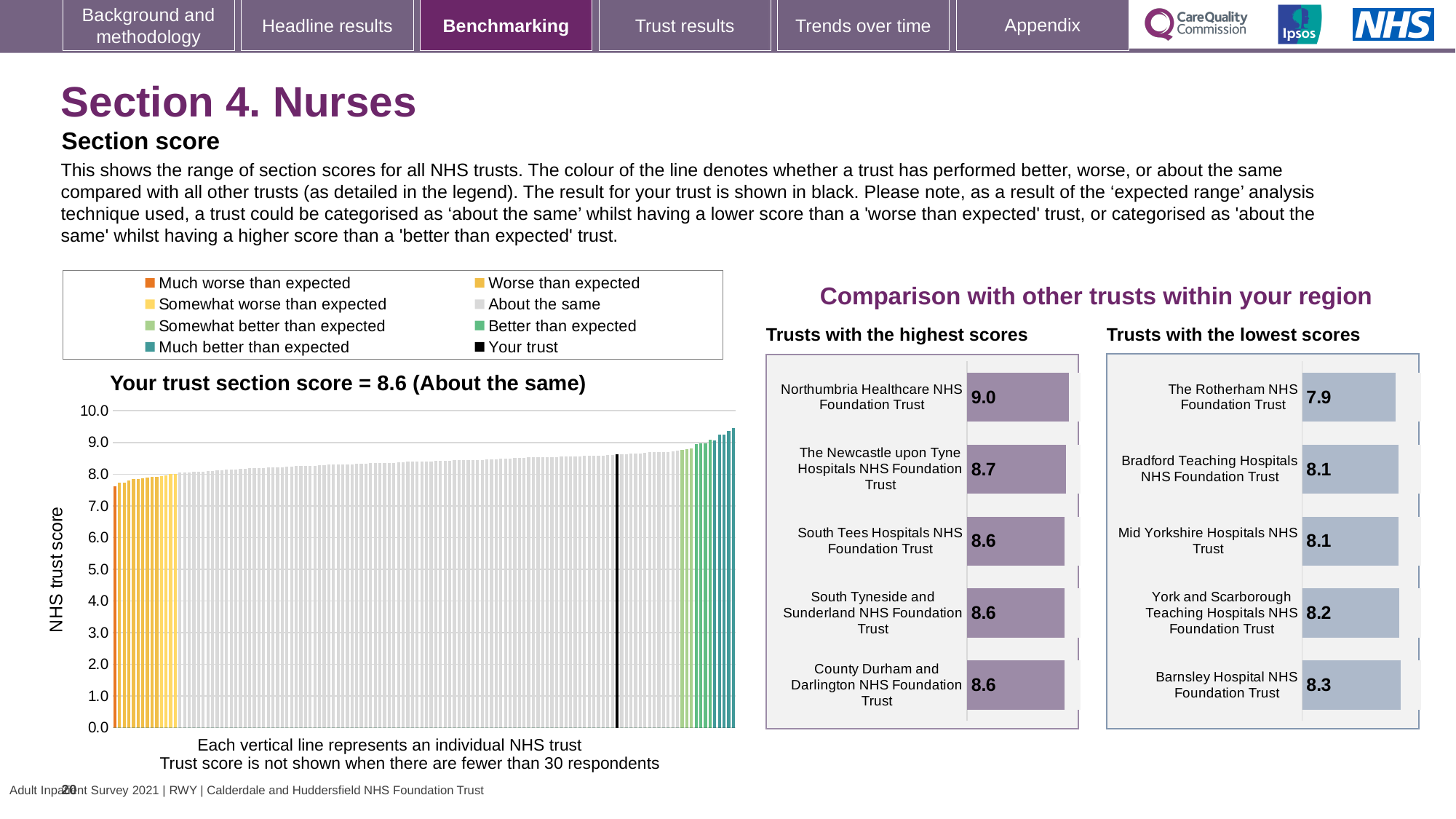
In the 'Trusts with the lowest scores' chart, what is the score for Barnsley Hospital NHS Foundation Trust? 8.3 In the 'Trusts with the highest scores' chart, what is the score for Northumbria Healthcare NHS Foundation Trust? 9.0 In the main chart on the left showing all NHS trusts, is the value of the leftmost (lowest) bar greater or less than 8.0? less In the 'Trusts with the highest scores' chart, what is the difference between the scores of Northumbria Healthcare NHS Foundation Trust and South Tees Hospitals NHS Foundation Trust? 0.4 In the 'Trusts with the highest scores' chart, what is the score for The Newcastle upon Tyne Hospitals NHS Foundation Trust? 8.7 What kind of chart is the main chart on the left showing all NHS trusts? bar chart In the 'Trusts with the lowest scores' chart, what is the score for The Rotherham NHS Foundation Trust? 7.9 In the main chart on the left showing all NHS trusts, what is your trust's section score? 8.6 In the 'Trusts with the lowest scores' chart, which has the larger score: York and Scarborough Teaching Hospitals NHS Foundation Trust or The Rotherham NHS Foundation Trust? York and Scarborough Teaching Hospitals NHS Foundation Trust In the 'Trusts with the lowest scores' chart, which trust has the lowest score? The Rotherham NHS Foundation Trust In the 'Trusts with the lowest scores' chart, how many trusts are shown? 5 In the 'Trusts with the highest scores' chart, which trust has the highest score? Northumbria Healthcare NHS Foundation Trust